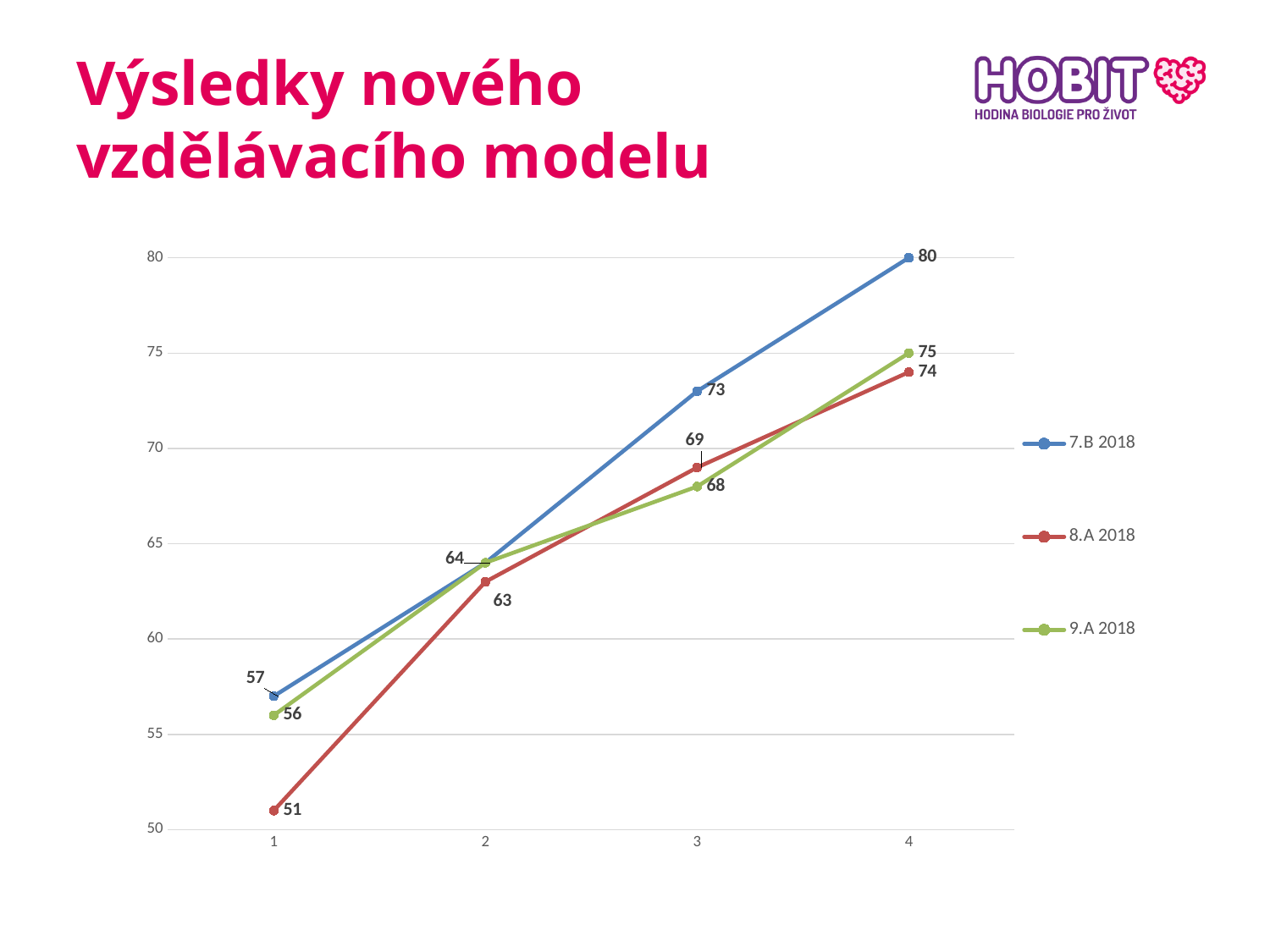
Do the values for 8.A 2018 rise or fall from point 1 to point 4? rise What is the difference between 7.B 2018 and 8.A 2018 at point 4? 6 What kind of chart is shown on the slide? line chart At point 3, which is larger: 8.A 2018 or 9.A 2018? 8.A 2018 By how much does 8.A 2018 increase from point 1 to point 4? 23 What is the value for 9.A 2018 at point 3? 68 Which series has the lowest value at point 1? 8.A 2018 What is the value for 7.B 2018 at point 4? 80 Which series has the highest value at point 4? 7.B 2018 What is the value for 8.A 2018 at point 1? 51 What is the value for 8.A 2018 at point 2? 63 How many series does the legend list? 3